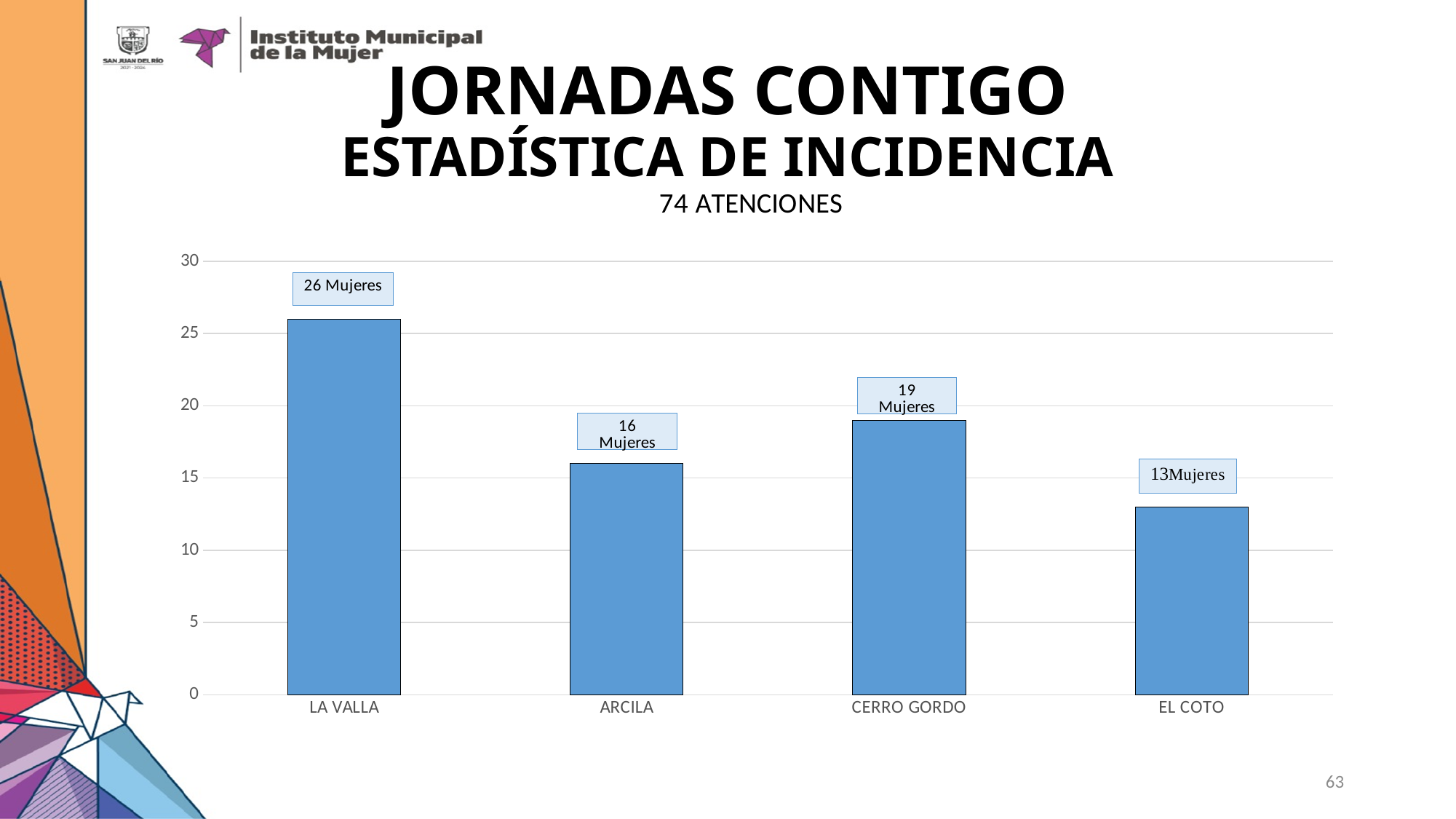
How many locations are shown on the x axis of the chart? 4 What kind of chart is shown on the slide? Bar chart Which location has the lowest number of women attended? EL COTO What is the difference between the values for CERRO GORDO and ARCILA? 3 Which location has the highest number of women attended? LA VALLA Which has a larger value, ARCILA or CERRO GORDO? CERRO GORDO What is the difference between the values for LA VALLA and EL COTO? 13 How many women (Mujeres) are shown for EL COTO? 13Mujeres How many women (Mujeres) are shown for CERRO GORDO? 19 Mujeres What total number of attentions is stated above the chart? 74 ATENCIONES How many women (Mujeres) are shown for ARCILA? 16 Mujeres How many women (Mujeres) are shown for LA VALLA? 26 Mujeres